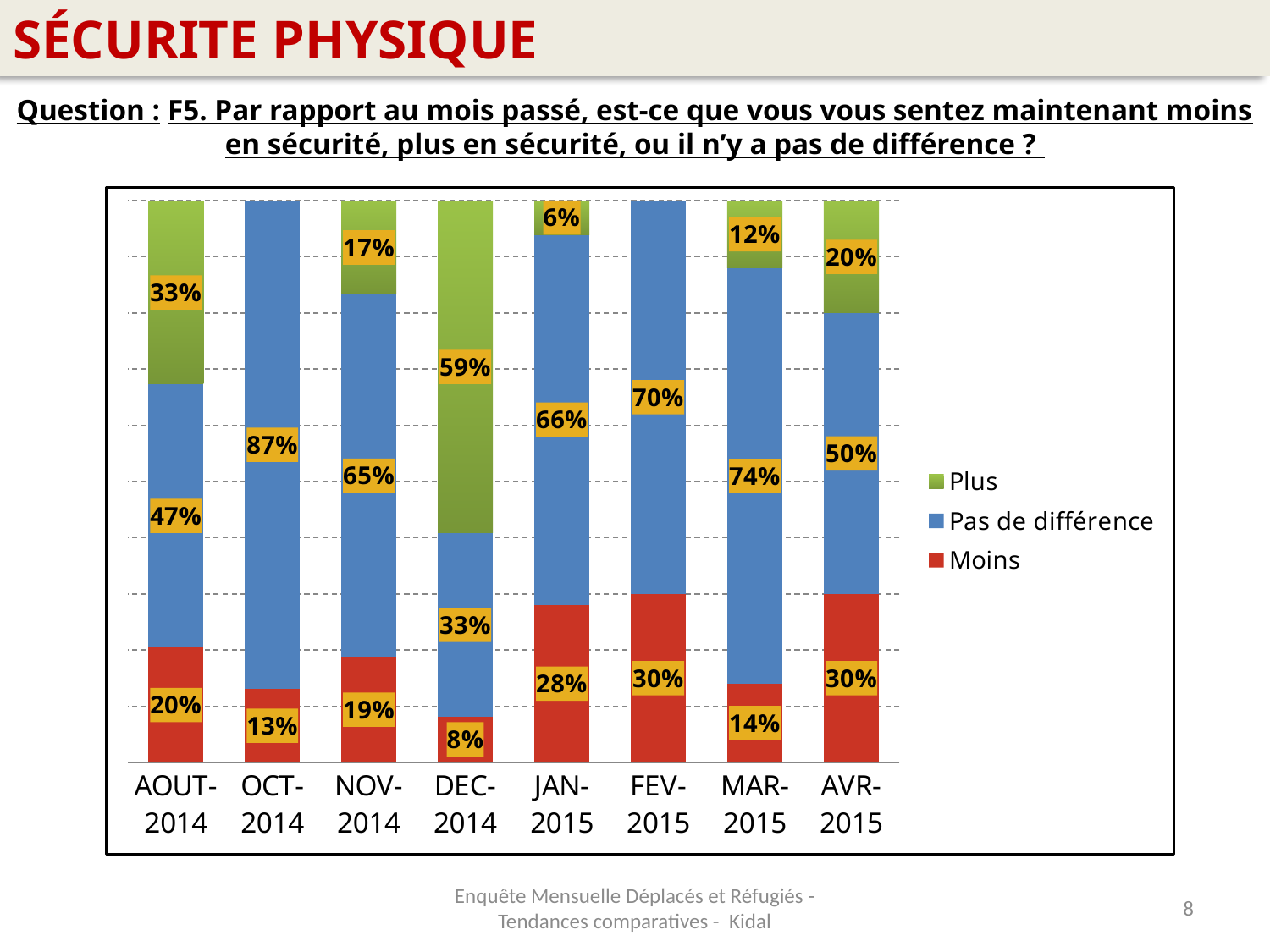
Which is larger: the "Moins" value for JAN-2015 or for MAR-2015? JAN-2015 In which month is the "Moins" share the lowest? DEC-2014 What kind of chart is shown on the slide? Stacked bar chart How many series does the legend list? 3 In which month is the "Plus" share the highest? DEC-2014 How many months are shown on the x axis? 8 Which colour represents the "Moins" series in the legend? Red In which month is the "Pas de différence" share the highest? OCT-2014 What percentage of respondents answered "Moins" in DEC-2014? 8% What is the difference between the "Pas de différence" values for MAR-2015 and AVR-2015? 24% What is the value for "Pas de différence" in OCT-2014? 87% What is the value for "Plus" in AVR-2015? 20%